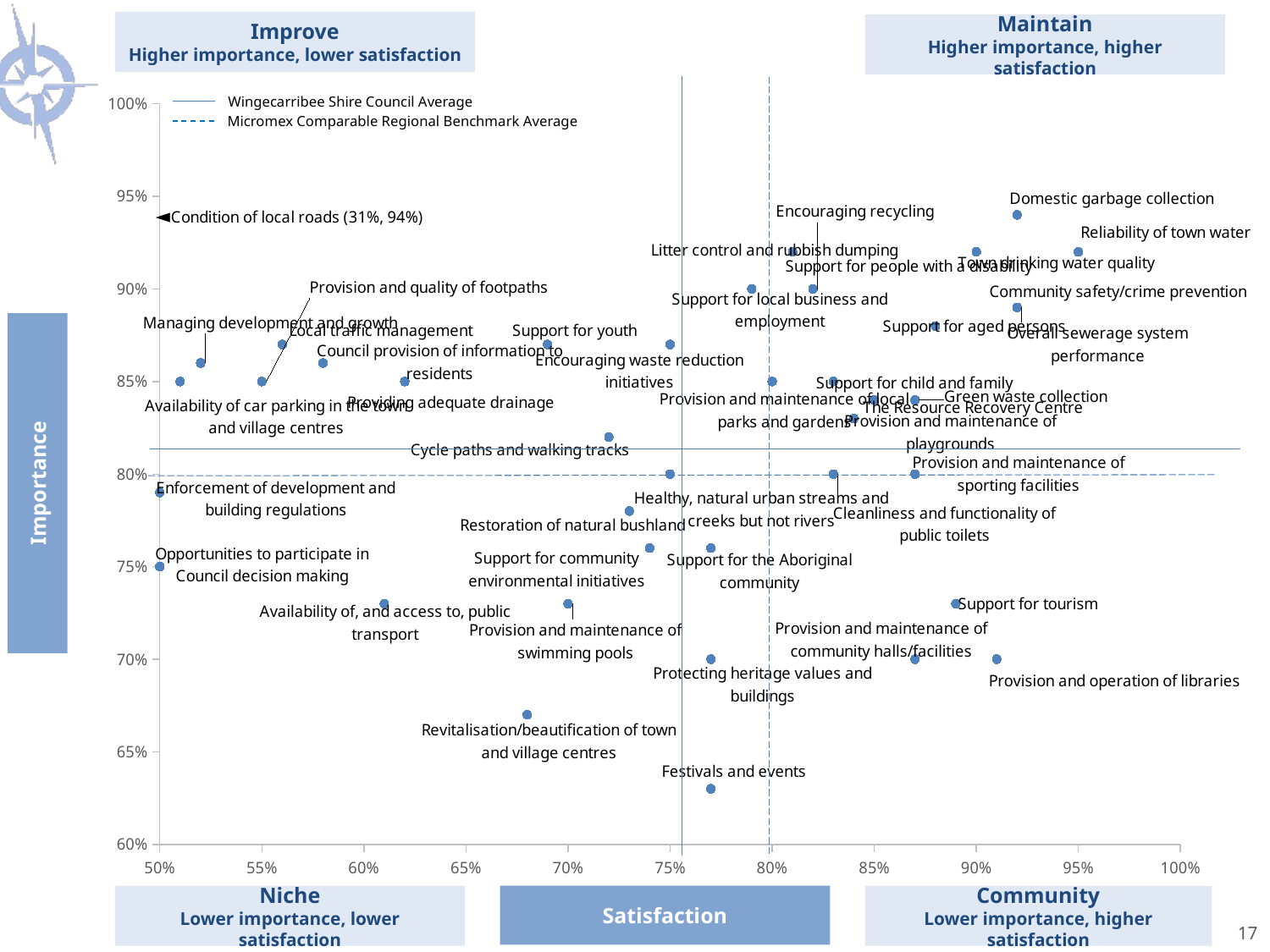
Which has the higher satisfaction, Condition of local roads or Domestic garbage collection? Domestic garbage collection Is the satisfaction value for Opportunities to participate in Council decision making greater or less than 55%? less Is the importance value for Revitalisation/beautification of town and village centres greater or less than 70%? less Is the importance value for Festivals and events greater or less than 65%? less Which has the higher importance, Festivals and events or Support for tourism? Support for tourism What is the importance value printed for Condition of local roads? 94% What satisfaction and importance values are printed for Condition of local roads? 31%, 94% What kind of chart is shown on the slide? Scatter chart What does the dashed line in the legend represent? Micromex Comparable Regional Benchmark Average Which service has the lowest importance on the chart? Festivals and events What is the label of the horizontal axis? Satisfaction